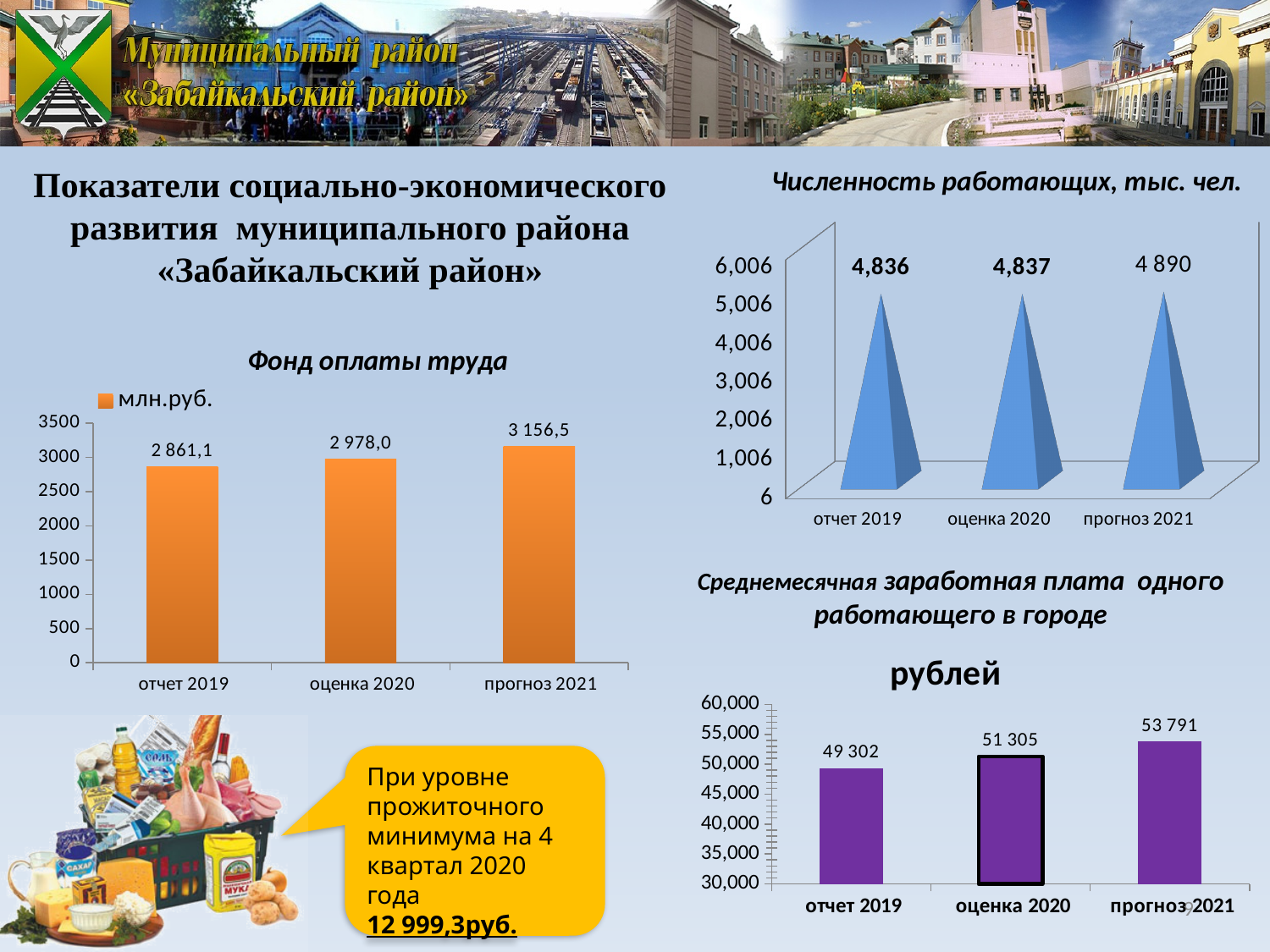
On the 'Фонд оплаты труда' chart, what is the difference between прогноз 2021 and отчет 2019? 295,4 On the 'Численность работающих, тыс. чел.' chart, what is the value for прогноз 2021? 4 890 On the 'Фонд оплаты труда' chart, what is the value for оценка 2020? 2 978,0 On the 'Среднемесячная заработная плата одного работающего в городе' chart, what is the difference between прогноз 2021 and отчет 2019? 4 489 On the 'Фонд оплаты труда' chart, do the values rise or fall from отчет 2019 to прогноз 2021? rise On the 'Численность работающих, тыс. чел.' chart, how many categories are shown? 3 On the 'Фонд оплаты труда' chart, which category has the highest value? прогноз 2021 On the 'Среднемесячная заработная плата одного работающего в городе' chart, which category has the lowest value? отчет 2019 On the 'Численность работающих, тыс. чел.' chart, which category has the highest value? прогноз 2021 On the 'Среднемесячная заработная плата одного работающего в городе' chart, what is the value for отчет 2019? 49 302 What kind of chart is the 'Среднемесячная заработная плата одного работающего в городе' chart? bar chart On the 'Фонд оплаты труда' chart, what unit does the legend give? млн.руб.